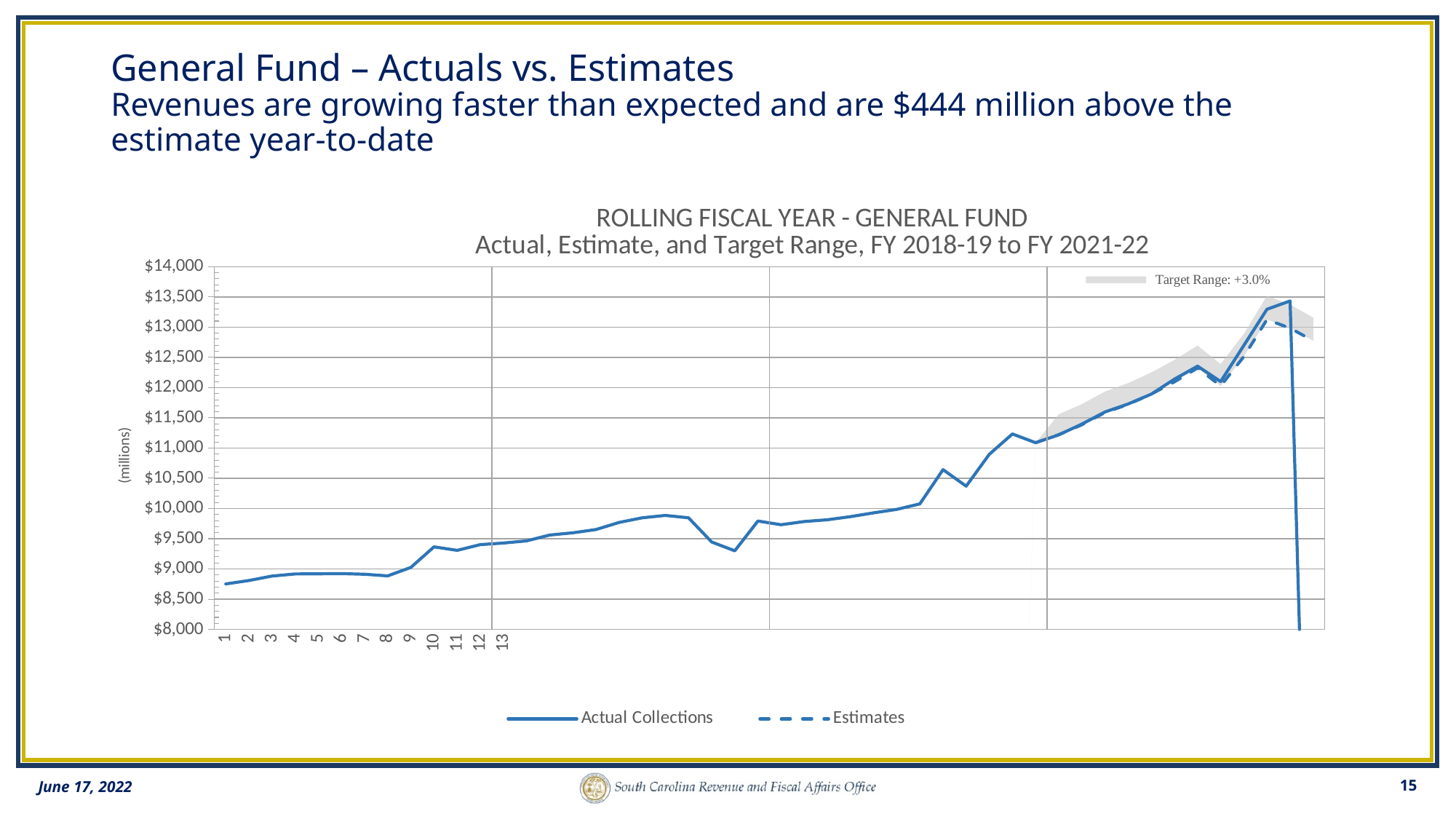
What is the title of the chart? ROLLING FISCAL YEAR - GENERAL FUND Actual, Estimate, and Target Range, FY 2018-19 to FY 2021-22 Is the Actual Collections value at point 10 greater or less than $9,500? less What is the unit shown on the y-axis label? (millions) Is the Actual Collections value at point 5 greater or less than $9,000? less Is the Actual Collections value at point 8 greater or less than $9,000? less How many series does the legend list? 2 Is the Actual Collections value at point 10 larger or smaller than at point 1? larger Do Actual Collections generally rise or fall from point 1 to point 13? rise Which series is drawn with a dashed line in the legend? Estimates What kind of chart is shown on the slide? line chart